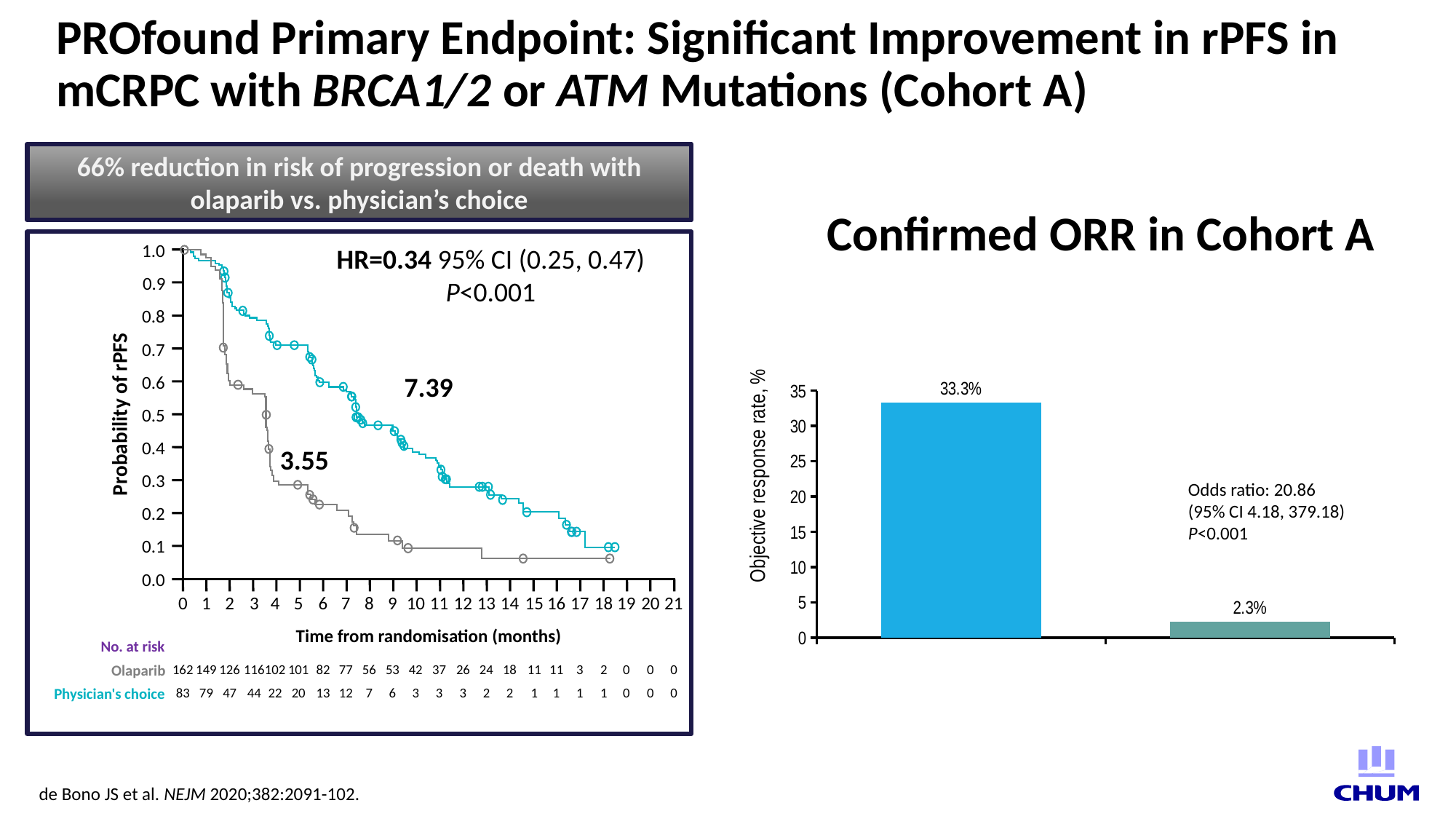
What is the y-axis label of the 'Confirmed ORR in Cohort A' chart? Objective response rate, % In the 'Confirmed ORR in Cohort A' chart, which bar is taller, the left blue bar or the right green bar? the left blue bar How many bars are plotted in the 'Confirmed ORR in Cohort A' chart? 2 What odds ratio is printed on the 'Confirmed ORR in Cohort A' chart? 20.86 In the 'Confirmed ORR in Cohort A' chart, what is the difference between the two labelled bar values? 31.0% In the 'Confirmed ORR in Cohort A' chart, what value is labelled on the left (blue) bar? 33.3% In the Kaplan-Meier chart on the left, what median value is printed next to the upper (teal) curve? 7.39 In the Kaplan-Meier chart on the left, how many Olaparib patients are listed at risk at time 0 in the 'No. at risk' table? 162 What kind of chart is the 'Confirmed ORR in Cohort A' chart on the right? bar chart In the 'Confirmed ORR in Cohort A' chart, what value is labelled on the right (green) bar? 2.3% In the Kaplan-Meier chart on the left, do the curves rise or fall as time from randomisation increases? fall In the Kaplan-Meier chart on the left, what hazard ratio (HR) is printed? 0.34